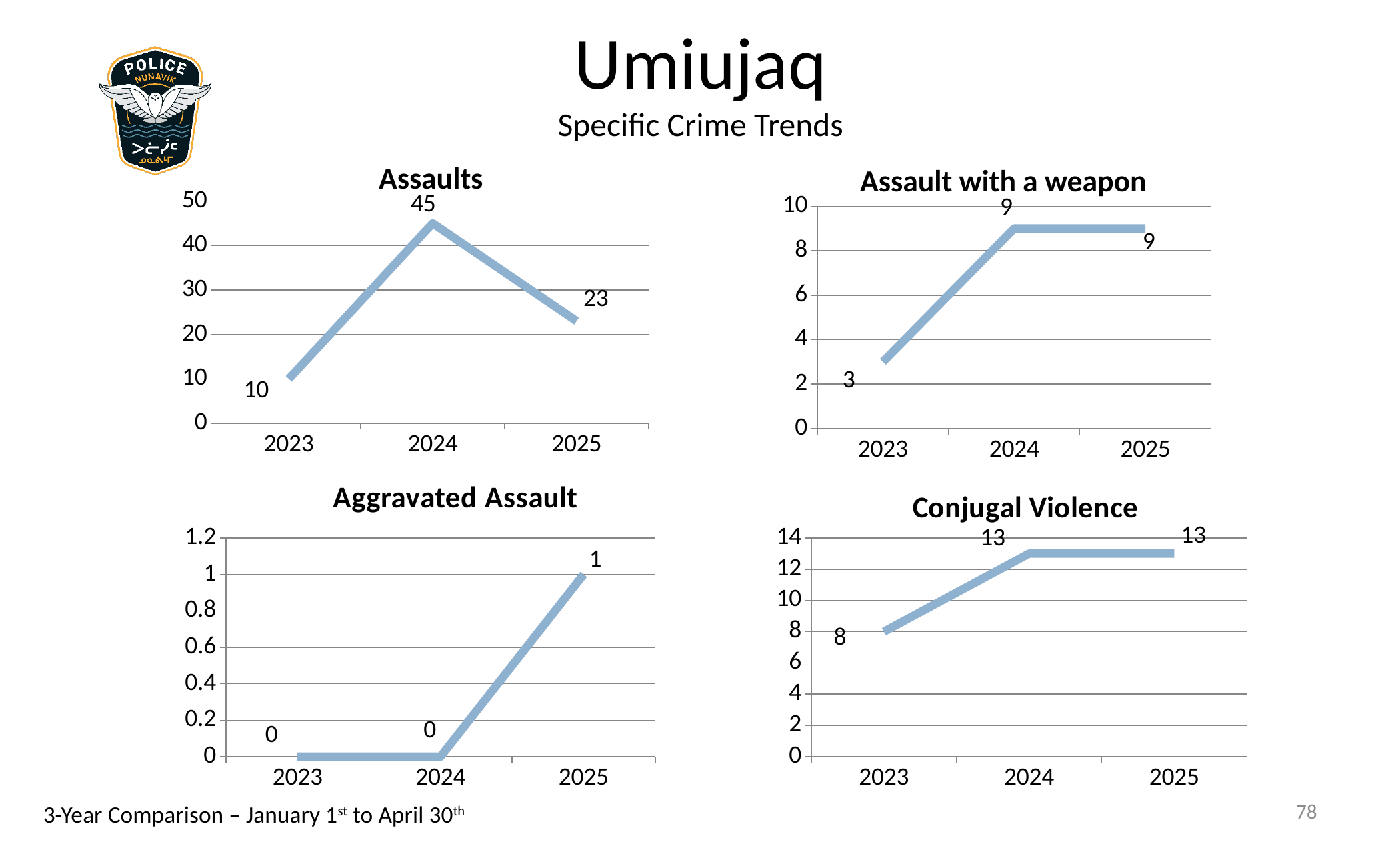
In the Conjugal Violence chart, do the values rise or fall from 2023 to 2024? rise In the Assault with a weapon chart, is the value for 2024 larger or smaller than the value for 2023? larger In the Assault with a weapon chart, what is the value for 2023? 3 In the Conjugal Violence chart, what is the value for 2023? 8 In the Assaults chart, which year has the lowest value? 2023 In the Aggravated Assault chart, how many years are plotted? 3 How many charts are shown on the slide? 4 In the Assaults chart, what is the difference between the 2024 and 2025 values? 22 What kind of chart is the Assaults chart? line chart In the Conjugal Violence chart, what is the difference between the 2024 and 2023 values? 5 In the Assaults chart, what is the value for 2024? 45 In the Aggravated Assault chart, what is the value for 2025? 1